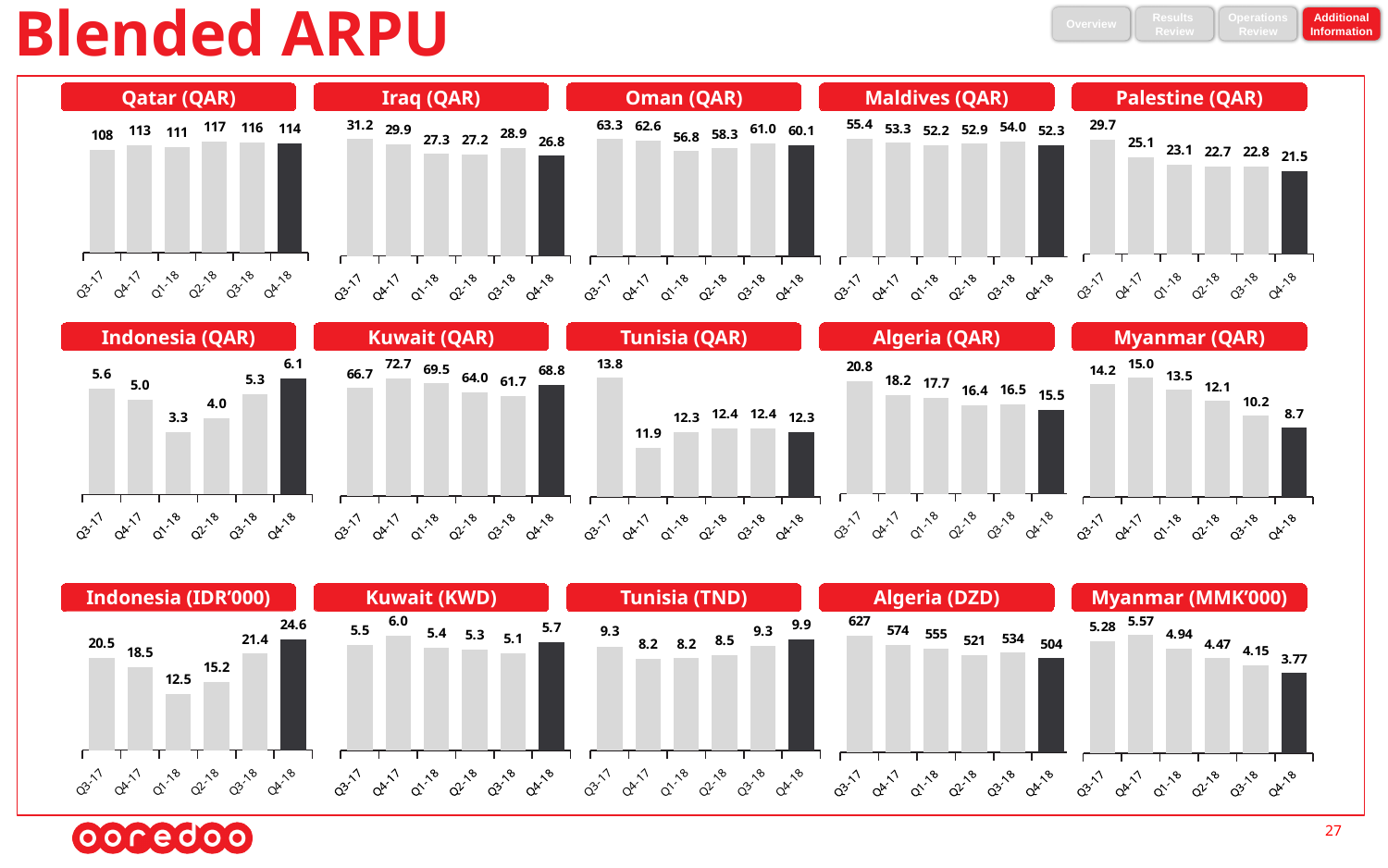
In the Maldives (QAR) chart, which quarter has the highest value? Q3-17 In the Myanmar (MMK'000) chart, what is the value for Q4-18? 3.77 In the Oman (QAR) chart, what is the difference between Q3-17 and Q1-18? 6.5 How many charts are shown on the slide? 15 In the Algeria (DZD) chart, what is the difference between Q3-17 and Q4-18? 123 In the Kuwait (QAR) chart, what is the value for Q4-17? 72.7 In the Palestine (QAR) chart, do the values generally rise or fall from Q3-17 to Q4-18? fall In the Iraq (QAR) chart, which quarter has the lowest value? Q4-18 In the Indonesia (QAR) chart, which is larger, Q4-17 or Q3-18? Q3-18 In the Tunisia (QAR) chart, how many quarters are plotted? 6 What kind of chart is the Indonesia (IDR'000) chart? bar chart In the Qatar (QAR) chart, what is the value for Q2-18? 117